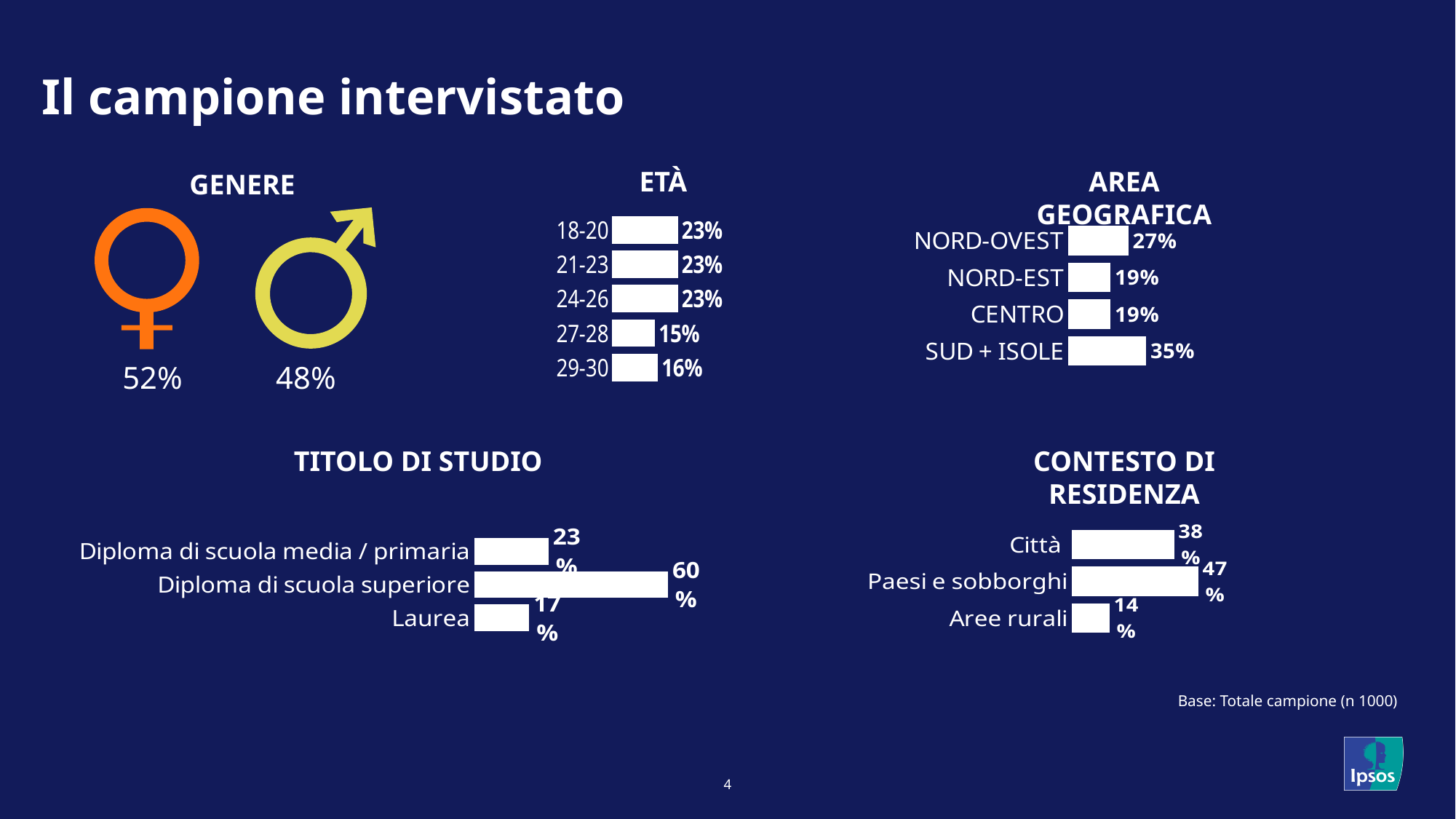
In the ETÀ chart, what is the value for the 27-28 age group? 15% In the AREA GEOGRAFICA chart, which area has the highest value? SUD + ISOLE In the TITOLO DI STUDIO chart, which category has the lowest value? Laurea In the CONTESTO DI RESIDENZA chart, what is the value for Aree rurali? 14% In the TITOLO DI STUDIO chart, what is the value for Diploma di scuola superiore? 60% In the CONTESTO DI RESIDENZA chart, what is the difference between Paesi e sobborghi and Città? 9% In the ETÀ chart, which age group has the lowest value? 27-28 What kind of chart is the TITOLO DI STUDIO chart? Bar chart In the AREA GEOGRAFICA chart, what is the value for SUD + ISOLE? 35% How many age groups are shown in the ETÀ chart? 5 In the AREA GEOGRAFICA chart, what is the difference between NORD-OVEST and NORD-EST? 8% In the CONTESTO DI RESIDENZA chart, which is larger, Città or Paesi e sobborghi? Paesi e sobborghi